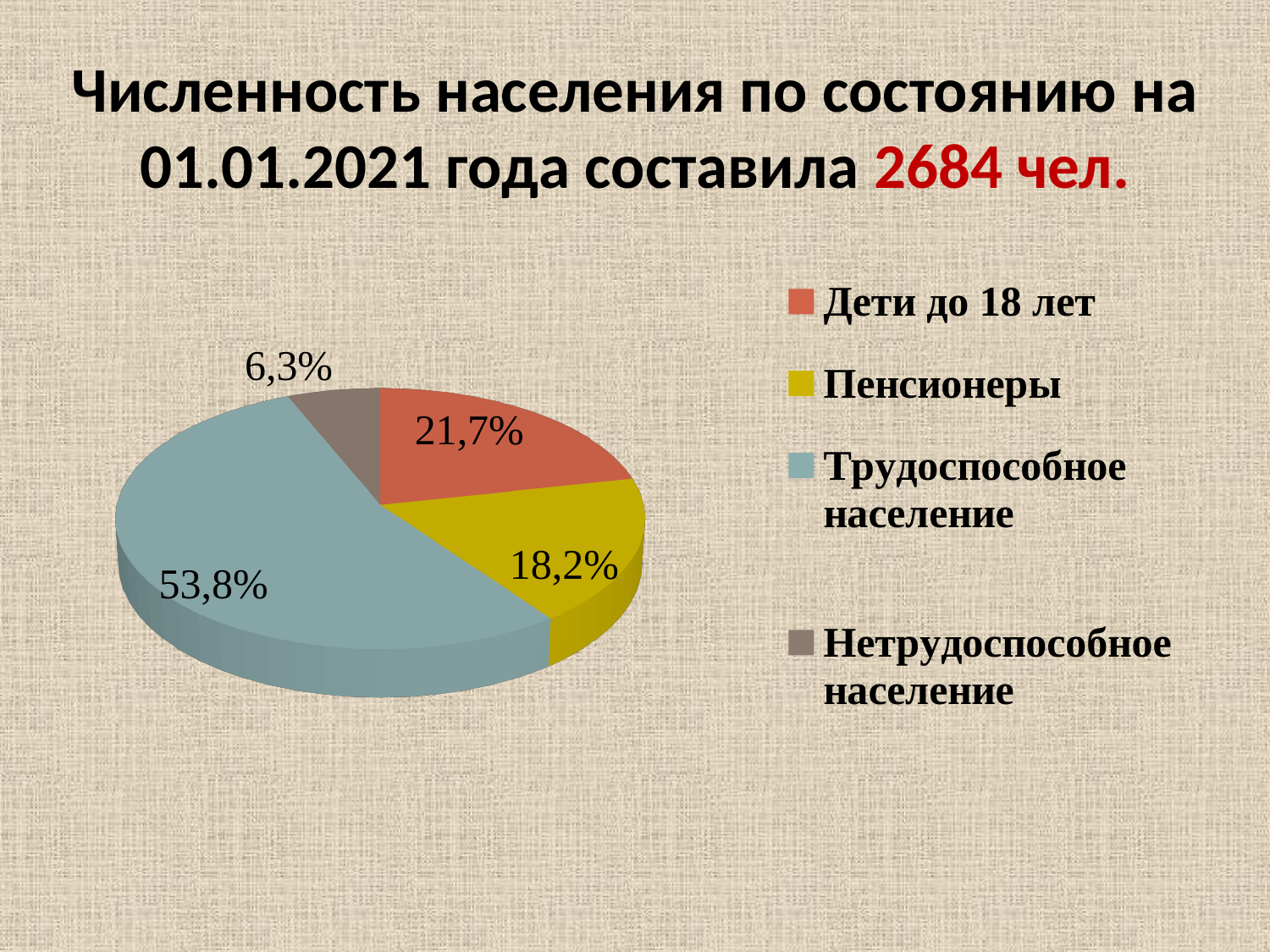
What total population figure is given in the slide title? 2684 чел. Which slice is larger: Пенсионеры or Нетрудоспособное население? Пенсионеры What share of the pie is labelled for Пенсионеры? 18,2% What share of the pie is labelled for Дети до 18 лет? 21,7% How many categories does the pie chart show? 4 What share of the pie is labelled for Трудоспособное население? 53,8% What share of the pie is labelled for Нетрудоспособное население? 6,3% Which category has the smallest slice of the pie? Нетрудоспособное население What is the difference in percentage points between Трудоспособное население and Дети до 18 лет? 32,1 What kind of chart is shown on the slide? Pie chart What is the difference in percentage points between Дети до 18 лет and Пенсионеры? 3,5 Which category has the largest slice of the pie? Трудоспособное население